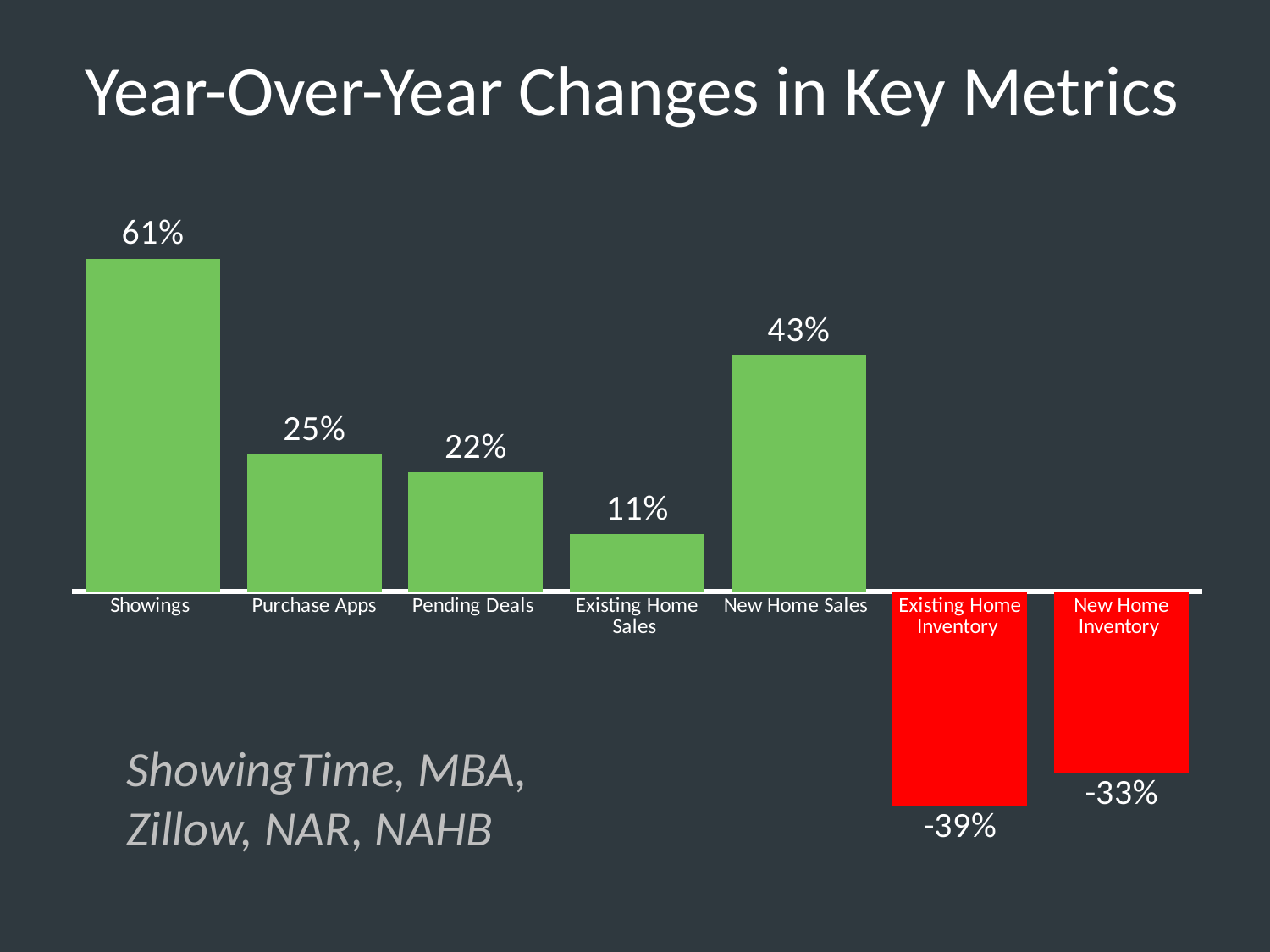
What colour are the bars with negative values? Red How many categories are shown in the chart? 7 Which category has the highest year-over-year change? Showings What is the difference between the values for Purchase Apps and Existing Home Sales? 14% What is the year-over-year change for Existing Home Inventory? -39% Which category has the lowest year-over-year change? Existing Home Inventory Which is larger, the value for Purchase Apps or the value for Pending Deals? Purchase Apps What is the year-over-year change for Showings? 61% What kind of chart is shown on the slide? Bar chart What is the year-over-year change for New Home Sales? 43% What is the difference between the values for Showings and New Home Sales? 18% What is the year-over-year change for Pending Deals? 22%